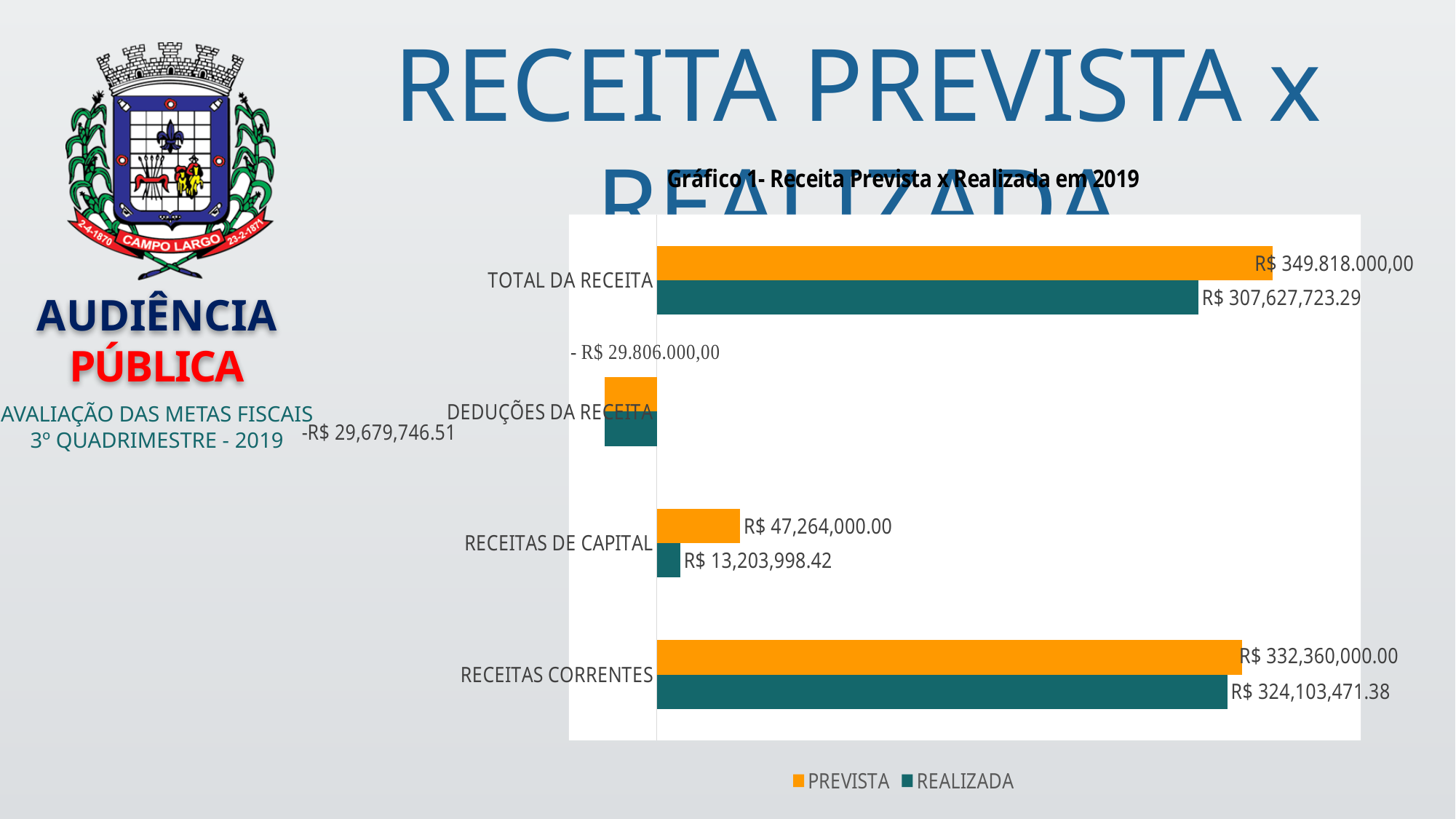
How many series does the legend list? 2 What is the PREVISTA value for RECEITAS CORRENTES? R$ 332,360,000.00 What is the REALIZADA value for TOTAL DA RECEITA? R$ 307,627,723.29 What is the difference between the PREVISTA and REALIZADA values for RECEITAS DE CAPITAL? R$ 34,060,001.58 What is the difference between the PREVISTA and REALIZADA values for RECEITAS CORRENTES? R$ 8,256,528.62 What is the PREVISTA value for DEDUÇÕES DA RECEITA? - R$ 29.806.000,00 What type of chart is shown on the slide? Bar chart How many categories are shown on the chart? 4 Which category has the lowest REALIZADA value? DEDUÇÕES DA RECEITA For RECEITAS DE CAPITAL, which is larger: PREVISTA or REALIZADA? PREVISTA What is the REALIZADA value for RECEITAS DE CAPITAL? R$ 13,203,998.42 Which category has the highest PREVISTA value? TOTAL DA RECEITA